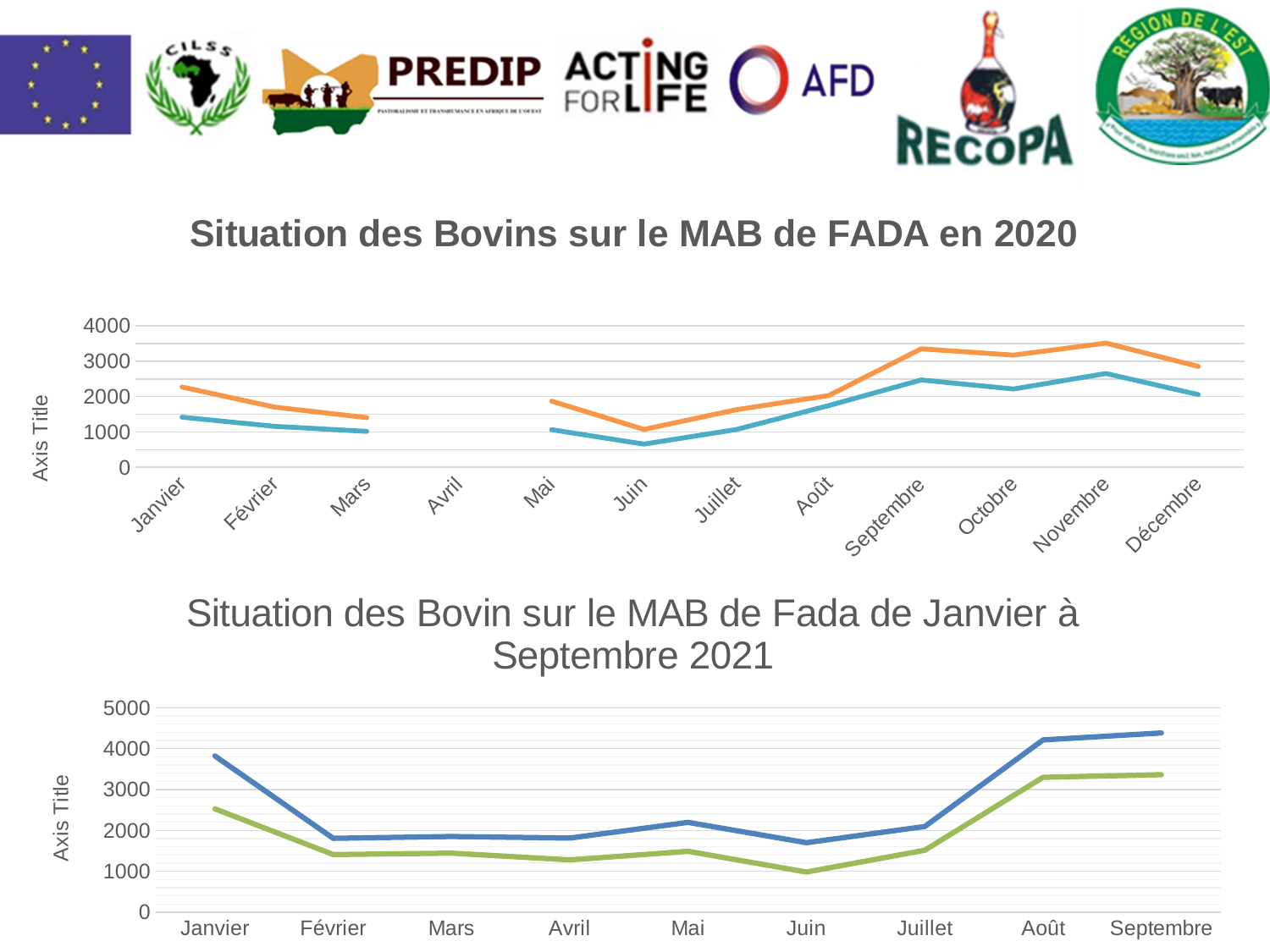
In the top chart (2020), in which month is the orange line at its lowest? Juin In the top chart (2020), in which month is the blue line at its lowest? Juin In the top chart (2020), is the blue line's value for Juin greater or less than 1000? less How many months are shown on the x axis of the bottom chart, 'Situation des Bovin sur le MAB de Fada de Janvier à Septembre 2021'? 9 In the bottom chart (2021), is the blue line's value for Août greater or less than 4000? greater In the bottom chart (2021), in which month is the green line at its lowest? Juin How many months are shown on the x axis of the top chart, 'Situation des Bovins sur le MAB de FADA en 2020'? 12 In the top chart (2020), is the orange line's value for Septembre greater or less than 3000? greater In the top chart (2020), which month has no data plotted for either line? Avril In the top chart (2020), is the orange line's value for Janvier larger or smaller than its value for Mars? larger What kind of chart is the top chart, 'Situation des Bovins sur le MAB de FADA en 2020'? Line chart In the bottom chart (2021), do the values of the blue line rise or fall from Juin to Septembre? rise